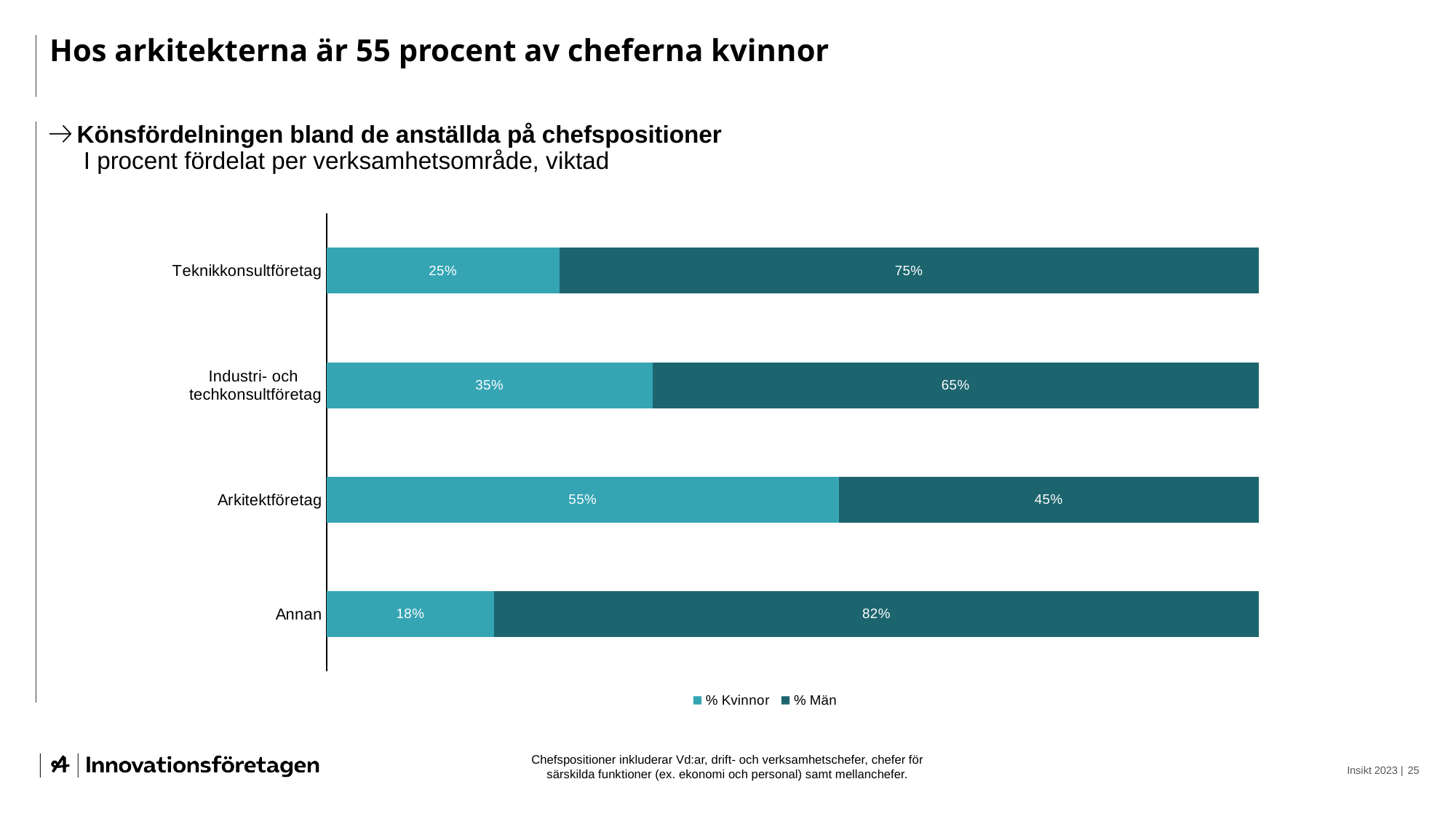
What is the % Kvinnor value for Arkitektföretag? 55% Which is larger: the % Kvinnor value for Teknikkonsultföretag or for Industri- och techkonsultföretag? Industri- och techkonsultföretag What kind of chart is shown on the slide? Stacked bar chart How many series does the legend list? 2 What is the % Män value for Teknikkonsultföretag? 75% Which category has the lowest % Kvinnor value? Annan What is the % Kvinnor value for Industri- och techkonsultföretag? 35% What is the total of the stacked bar for Industri- och techkonsultföretag? 100% What is the difference between the % Män values for Annan and Arkitektföretag? 37% Which category has the highest % Kvinnor value? Arkitektföretag How many categories are shown on the chart? 4 What is the % Män value for Annan? 82%